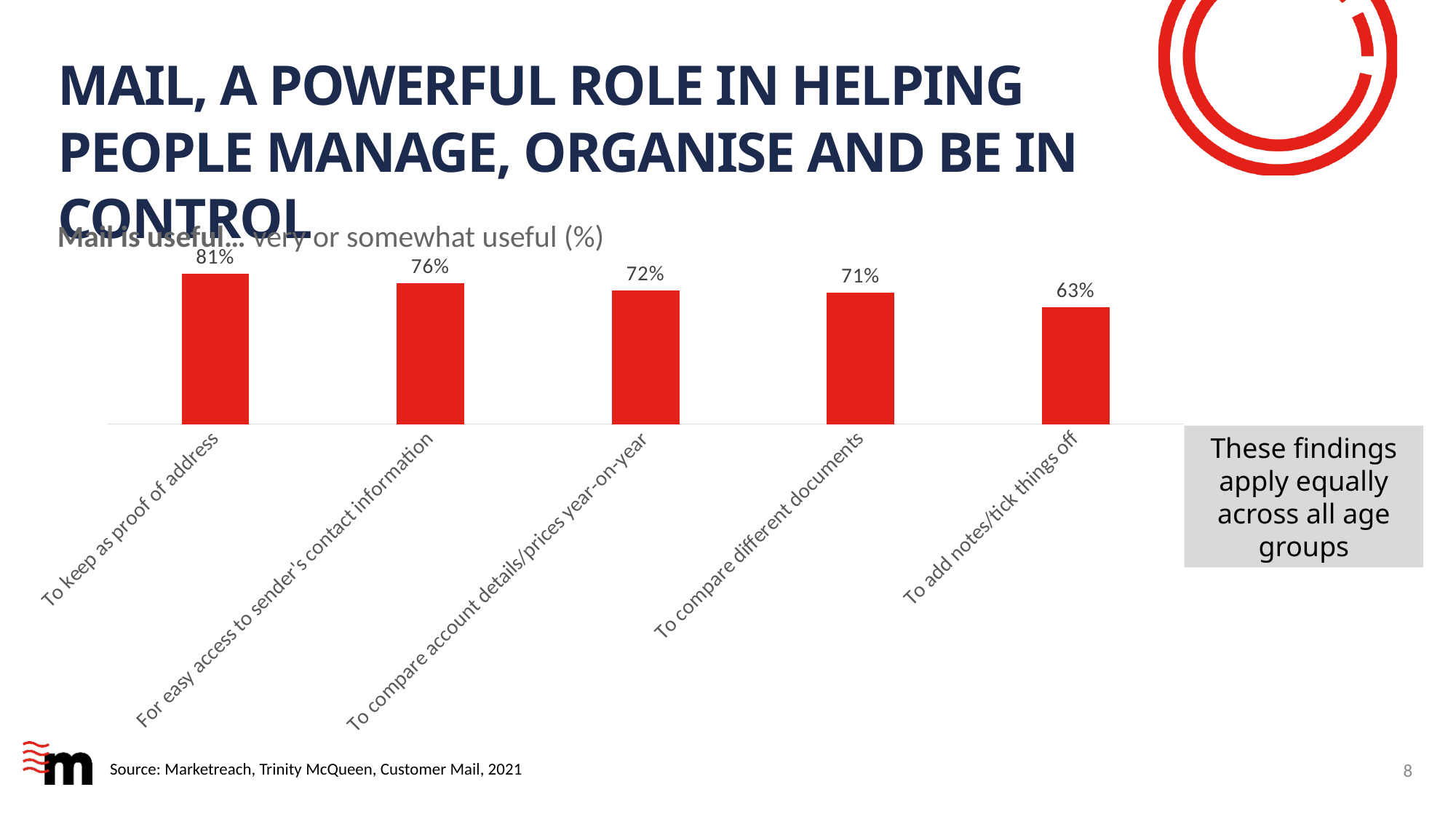
How many categories are shown in the chart? 5 Which is larger: the value for 'To compare account details/prices year-on-year' or 'To add notes/tick things off'? To compare account details/prices year-on-year What percentage of people find mail useful to keep as proof of address? 81% What is the value for 'To add notes/tick things off'? 63% What type of chart is shown on the slide? Bar chart What is the value for 'For easy access to sender's contact information'? 76% What is the value for 'To compare account details/prices year-on-year'? 72% Which category has the highest value? To keep as proof of address Do the values rise or fall from left to right across the chart? Fall What is the difference between 'For easy access to sender's contact information' and 'To compare different documents'? 5% Which category has the lowest value? To add notes/tick things off What is the difference between the values for 'To keep as proof of address' and 'To add notes/tick things off'? 18%